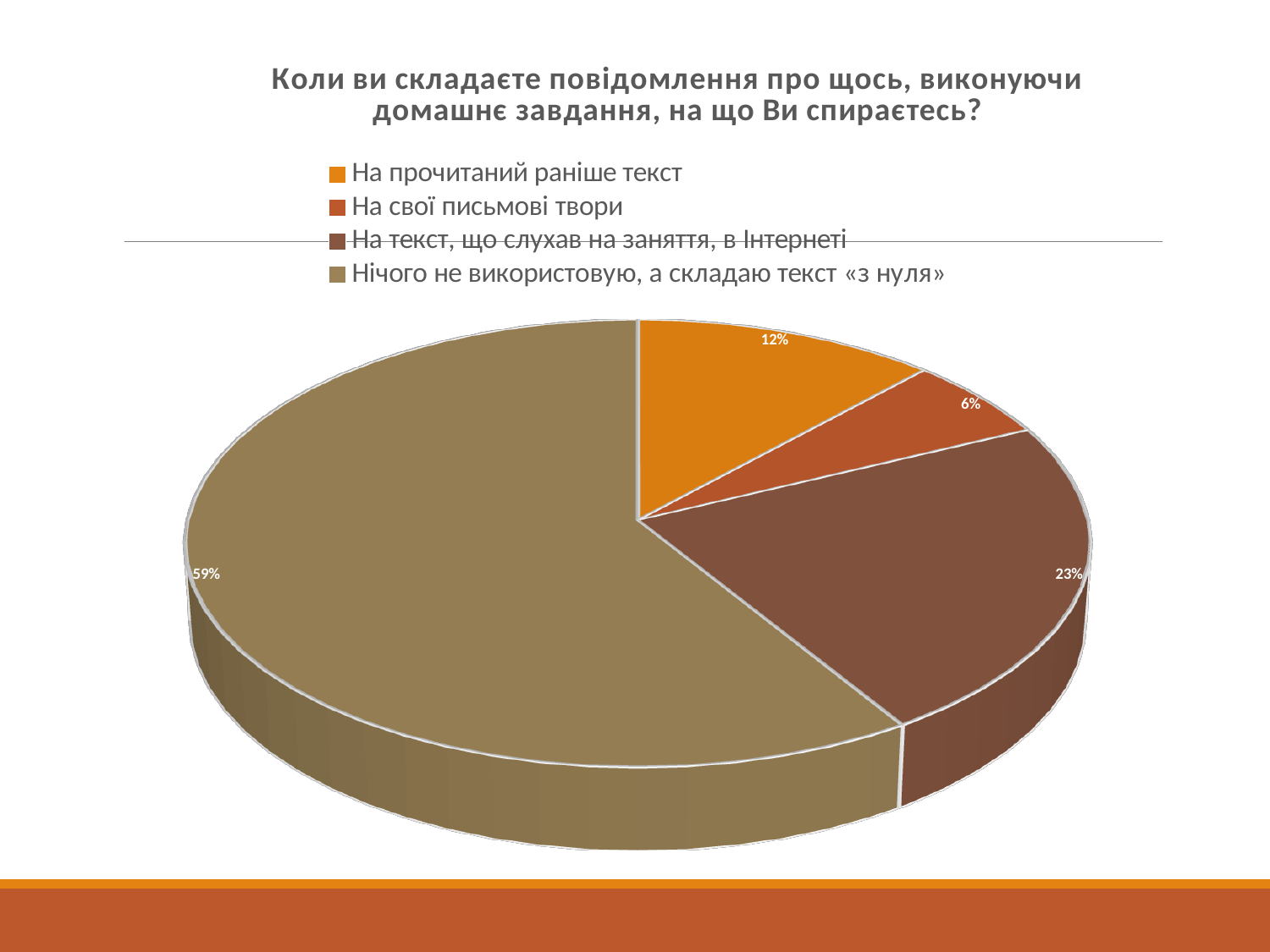
Which category has the largest share of the pie? Нічого не використовую, а складаю текст «з нуля» What percentage of the pie corresponds to "На свої письмові твори"? 6% What is the title of the chart? Коли ви складаєте повідомлення про щось, виконуючи домашнє завдання, на що Ви спираєтесь? Which is larger: the share for "На прочитаний раніше текст" or the share for "На свої письмові твори"? На прочитаний раніше текст What percentage of the pie corresponds to "На прочитаний раніше текст"? 12% What colour is the slice for "На прочитаний раніше текст"? Orange What percentage of the pie corresponds to "Нічого не використовую, а складаю текст «з нуля»"? 59% How many slices does the pie chart have? 4 Which category has the smallest share of the pie? На свої письмові твори What kind of chart is shown on the slide? Pie chart What is the difference in percentage points between "Нічого не використовую, а складаю текст «з нуля»" and "На текст, що слухав на заняття, в Інтернеті"? 36 percentage points What percentage of the pie corresponds to "На текст, що слухав на заняття, в Інтернеті"? 23%